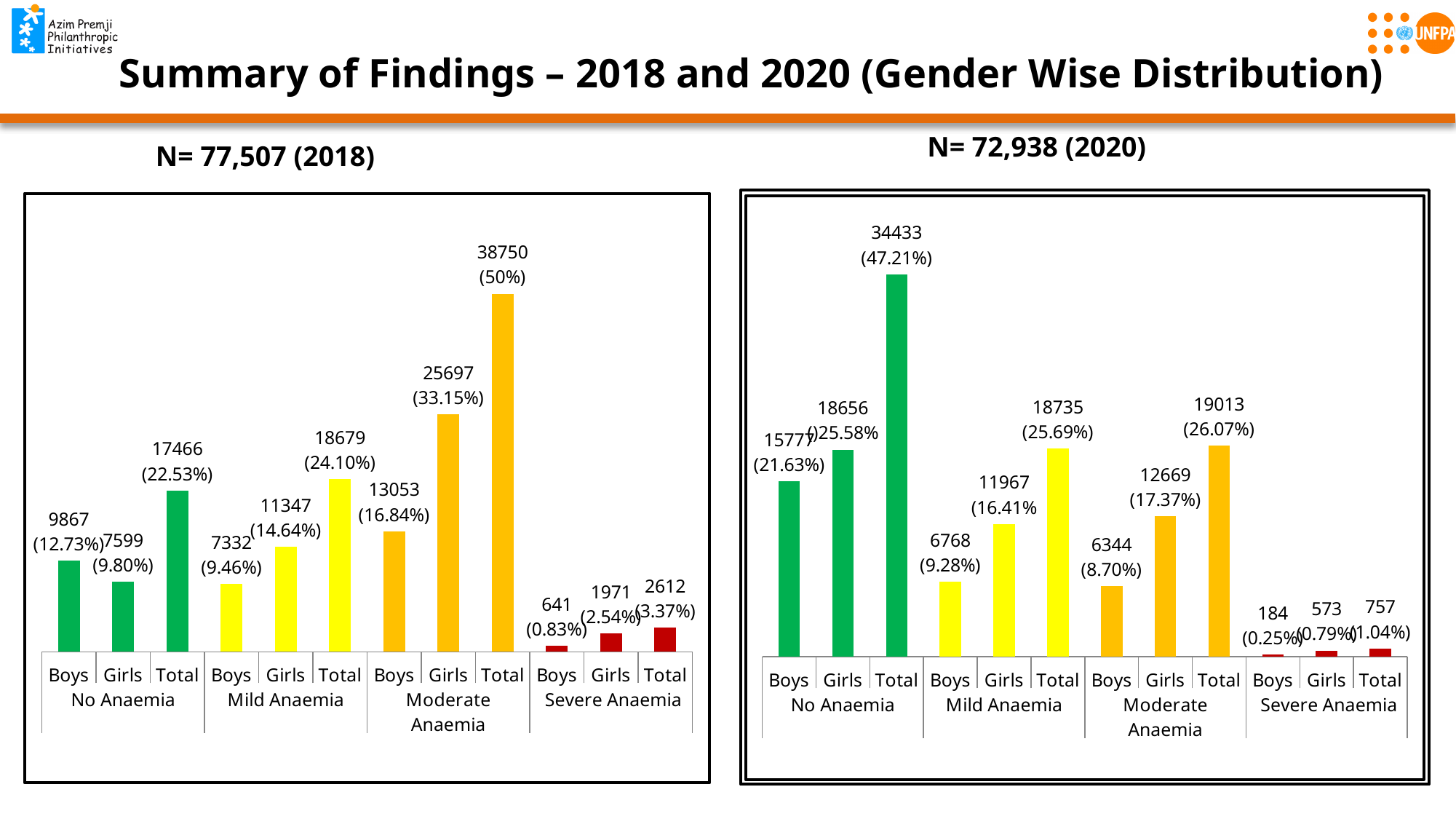
In the 2020 chart (N= 72,938), what is the difference between the Girls and Boys values for No Anaemia? 2879 In the 2020 chart (N= 72,938), what percentage is shown for the Total with No Anaemia? 47.21% In the 2020 chart (N= 72,938), which bar is the lowest? Boys, Severe Anaemia What type of chart is the 2018 chart (N= 77,507)? Bar chart In the 2018 chart (N= 77,507), what is the value for Boys with Severe Anaemia? 641 What colour are the Severe Anaemia bars in both charts? Red In the 2018 chart (N= 77,507), what is the difference between the Girls and Boys values for Mild Anaemia? 4015 In the 2020 chart (N= 72,938), what is the value for Girls with Severe Anaemia? 573 In the 2018 chart (N= 77,507), which bar is the highest? Total, Moderate Anaemia In the 2020 chart (N= 72,938), which is larger: the Total for Mild Anaemia or the Total for Moderate Anaemia? Total for Moderate Anaemia In the 2018 chart (N= 77,507), what is the value for Girls with Moderate Anaemia? 25697 How many bars are plotted in the 2020 chart (N= 72,938)? 12